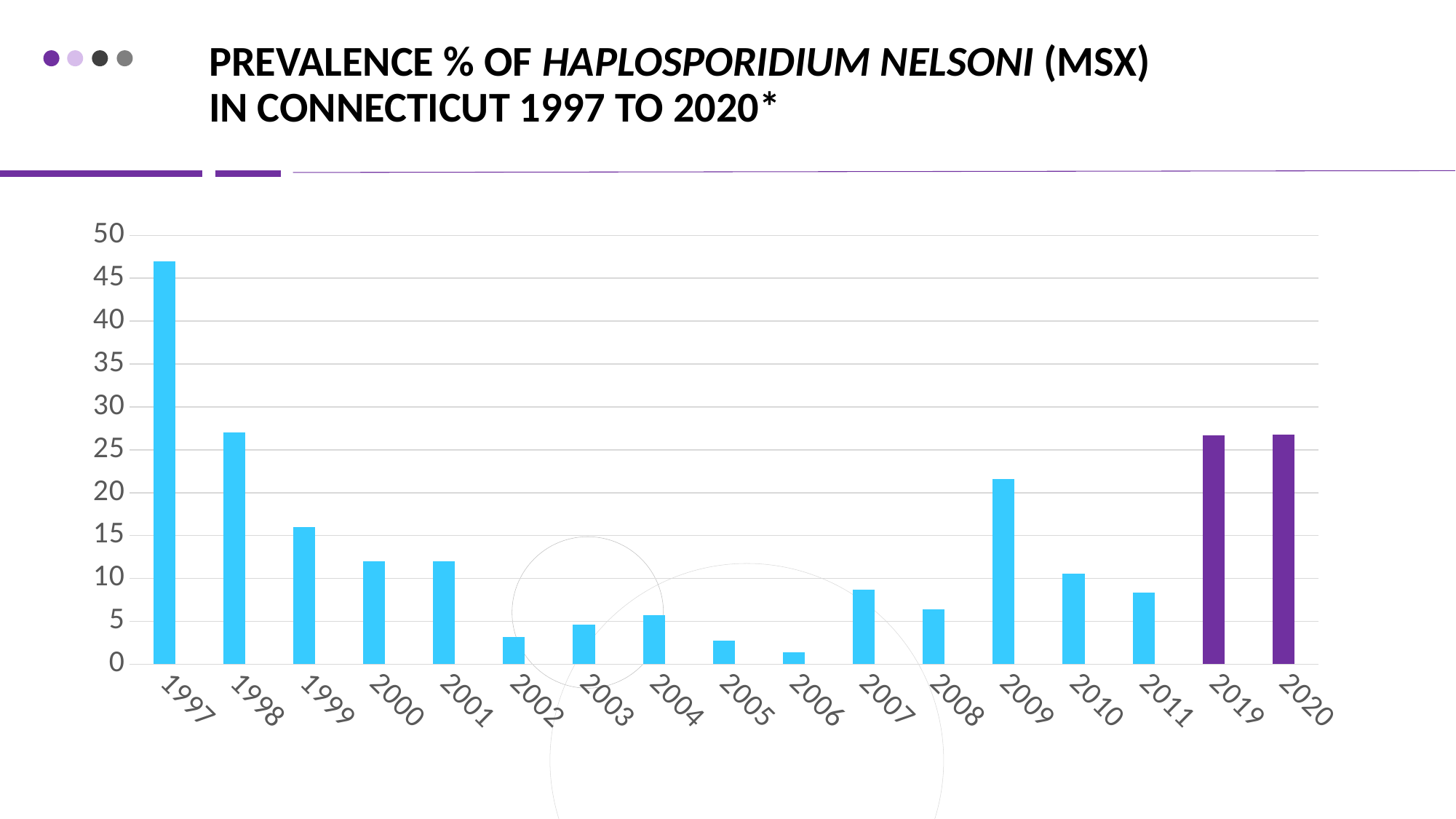
What kind of chart is shown on the slide? bar chart Which year has the larger value, 2007 or 2008? 2007 How many years (bars) are plotted on the chart? 17 Is the value for 1997 greater or less than 45? greater Do the values rise or fall from 1997 to 2002? fall Is the value for 2006 greater or less than 5? less Which year has the highest prevalence? 1997 What colour are the bars for 2019 and 2020? purple Is the value for 2011 greater or less than 10? less Which year has the lowest prevalence? 2006